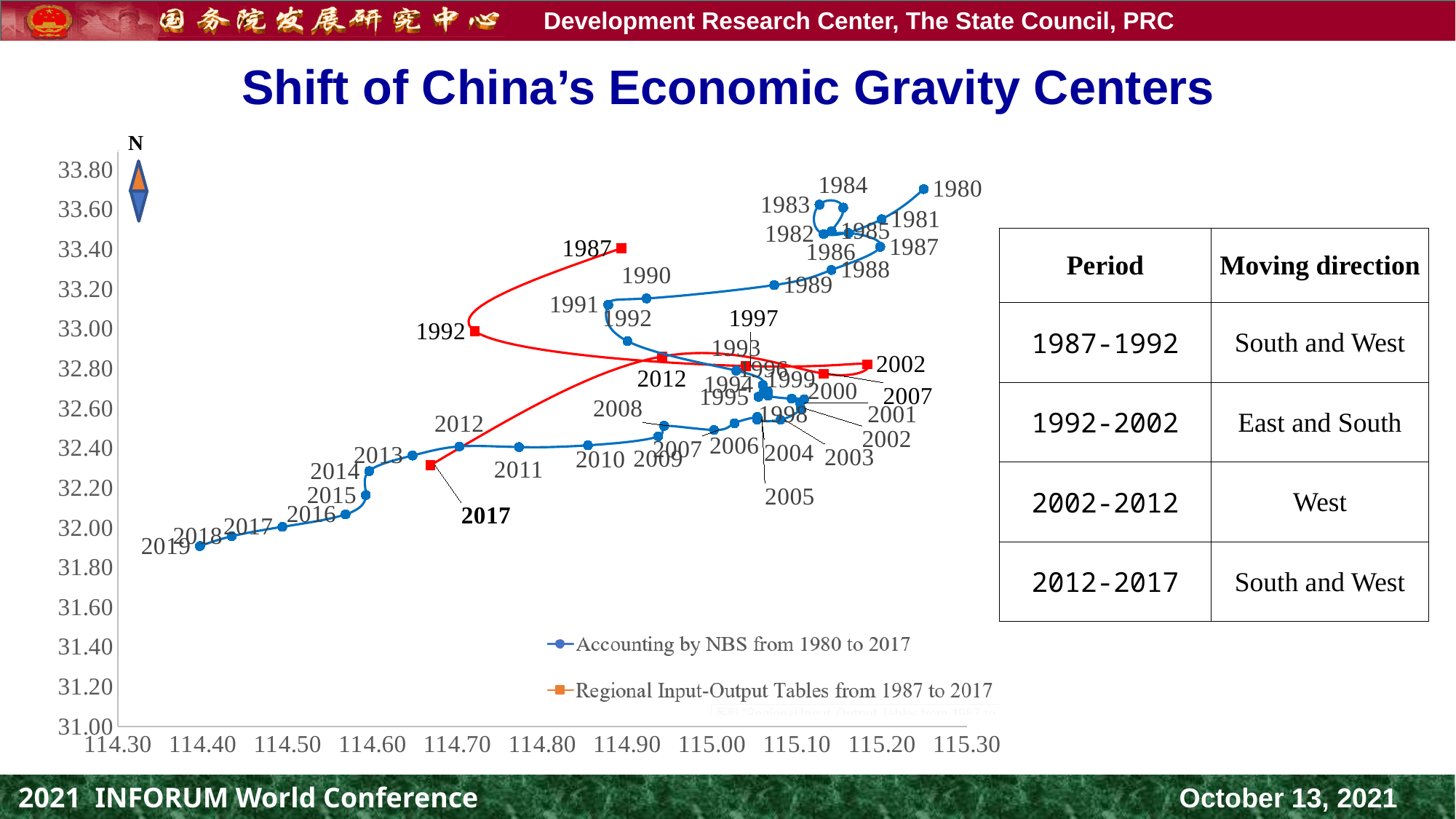
How many series does the chart legend list? 2 Is the latitude of the 1980 point in the NBS series greater or less than 33.60? greater What is the name of the series drawn in blue? Accounting by NBS from 1980 to 2017 Is the latitude of the 1987 point in the Regional Input-Output Tables series greater or less than 33.20? greater Which year's point in the NBS series has the highest latitude (vertical axis value)? 1980 Is the latitude of the 2019 point in the NBS series greater or less than 32.00? less How many points are plotted for the Regional Input-Output Tables series? 7 What is the name of the series drawn with red square markers? Regional Input-Output Tables from 1987 to 2017 What kind of chart is shown on the slide? Scatter (line) chart Which year's point in the NBS series has the lowest latitude (vertical axis value)? 2019 Which has the higher latitude in the NBS series, the 1980 point or the 2019 point? 1980